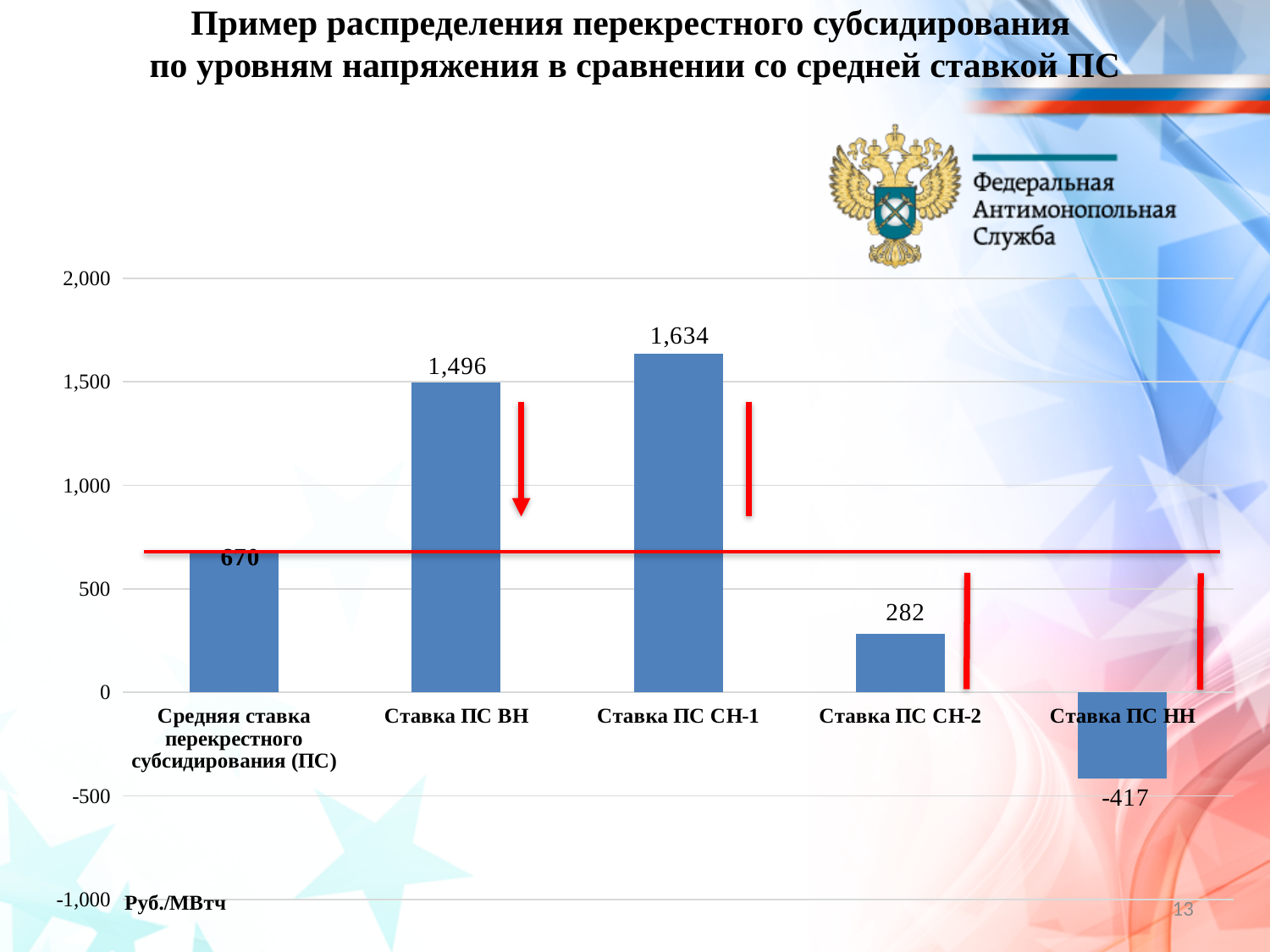
What is the difference between the values for Ставка ПС СН-1 and Ставка ПС ВН? 138 What is the value for Ставка ПС СН-1? 1,634 Is the value for Ставка ПС СН-2 greater or less than 500? less What is the value for Средняя ставка перекрестного субсидирования (ПС)? 670 What kind of chart is shown on the slide? bar chart Which category has the lowest value? Ставка ПС НН Which is larger, the value for Ставка ПС ВН or the value for Ставка ПС СН-2? Ставка ПС ВН Which category has the highest value? Ставка ПС СН-1 What is the value for Ставка ПС НН? -417 What is the value for Ставка ПС СН-2? 282 What is the value for Ставка ПС ВН? 1,496 How many categories are shown on the x axis? 5